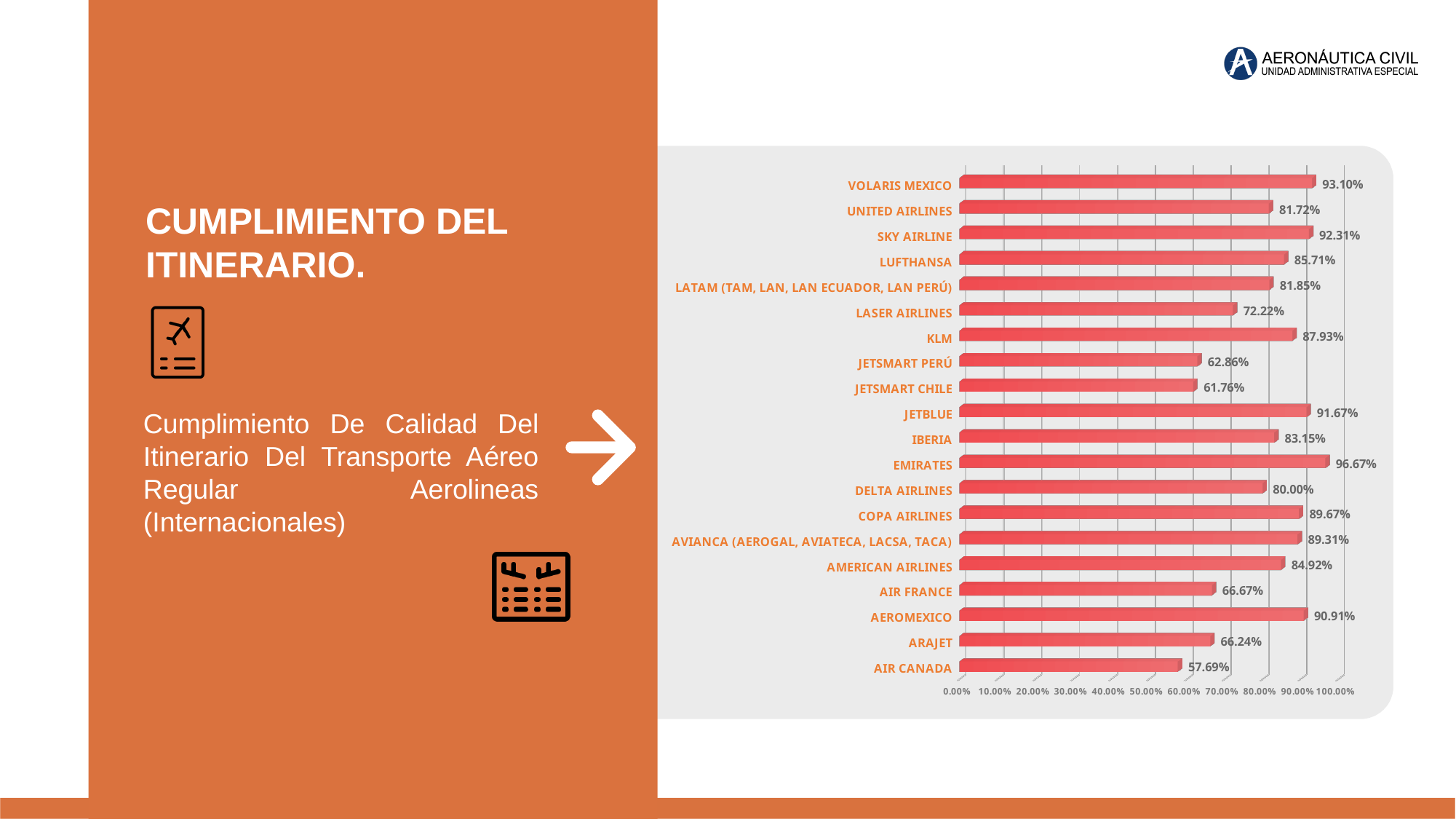
Which has a larger value, JETBLUE or IBERIA? JETBLUE What is the value for AIR CANADA? 57.69% How many airlines are shown in the chart? 20 What is the difference between the values for VOLARIS MEXICO and UNITED AIRLINES? 11.38 percentage points Which airline has the highest value? EMIRATES Which airline has the lowest value? AIR CANADA What kind of chart is shown on the slide? Bar chart What is the value for EMIRATES? 96.67% Is the value for AIR FRANCE greater or less than 70.00%? less What is the difference between the values for KLM and LASER AIRLINES? 15.71 percentage points What is the value for LASER AIRLINES? 72.22% What is the value for DELTA AIRLINES? 80.00%